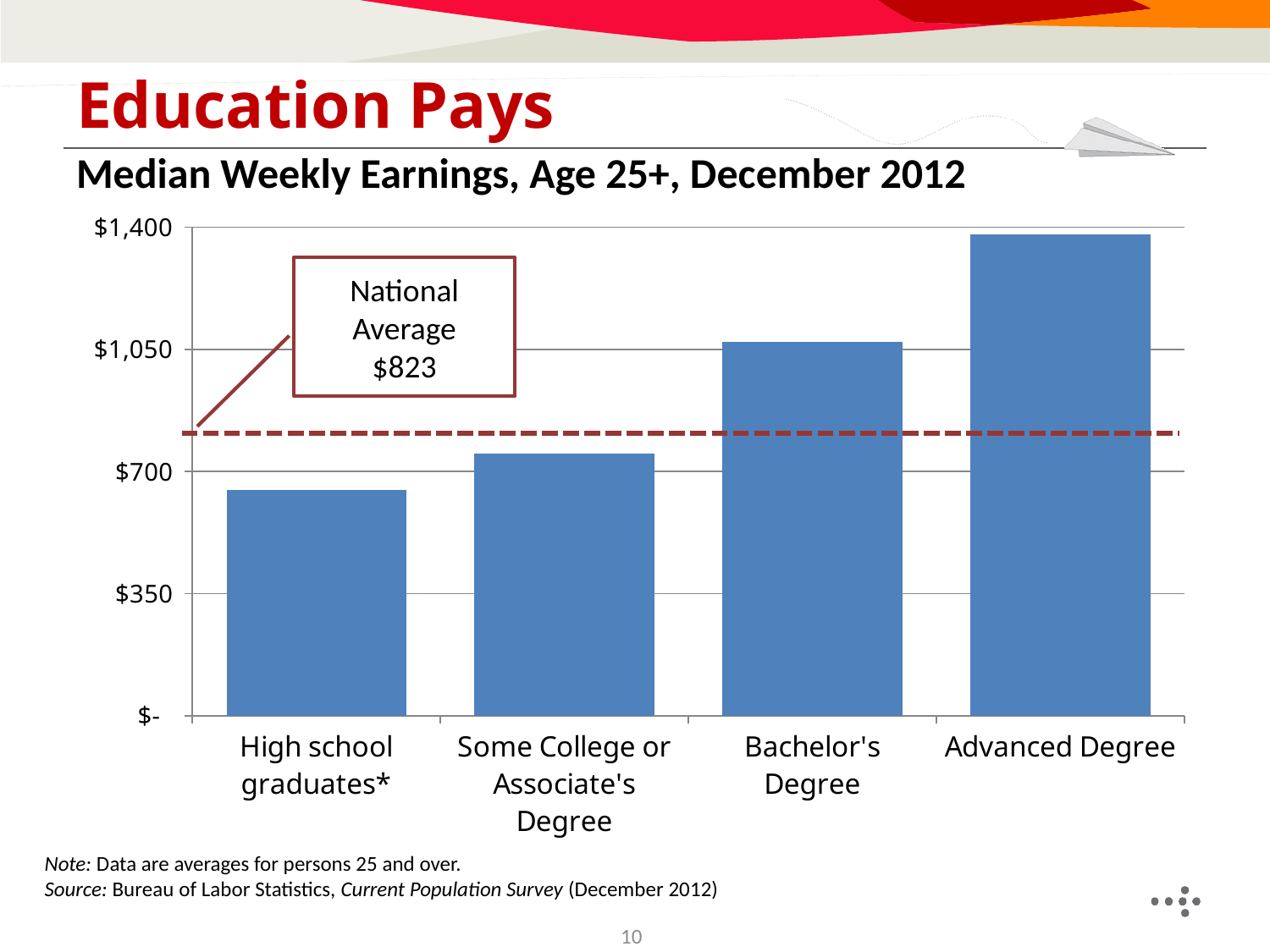
Which category has the lowest median weekly earnings? High school graduates* What kind of chart is shown on the slide? bar chart Which category has the highest median weekly earnings? Advanced Degree Is the value for Advanced Degree greater or less than $1,050? greater What is the title of the chart? Median Weekly Earnings, Age 25+, December 2012 How many education categories are shown on the x axis? 4 Do median weekly earnings rise or fall moving from left to right across the education categories? rise Is the value for Bachelor's Degree greater or less than $700? greater Is the value for Some College or Associate's Degree greater or less than $700? greater Which is larger, the value for Bachelor's Degree or the value for Some College or Associate's Degree? Bachelor's Degree What national average value is marked by the dashed line on the chart? $823